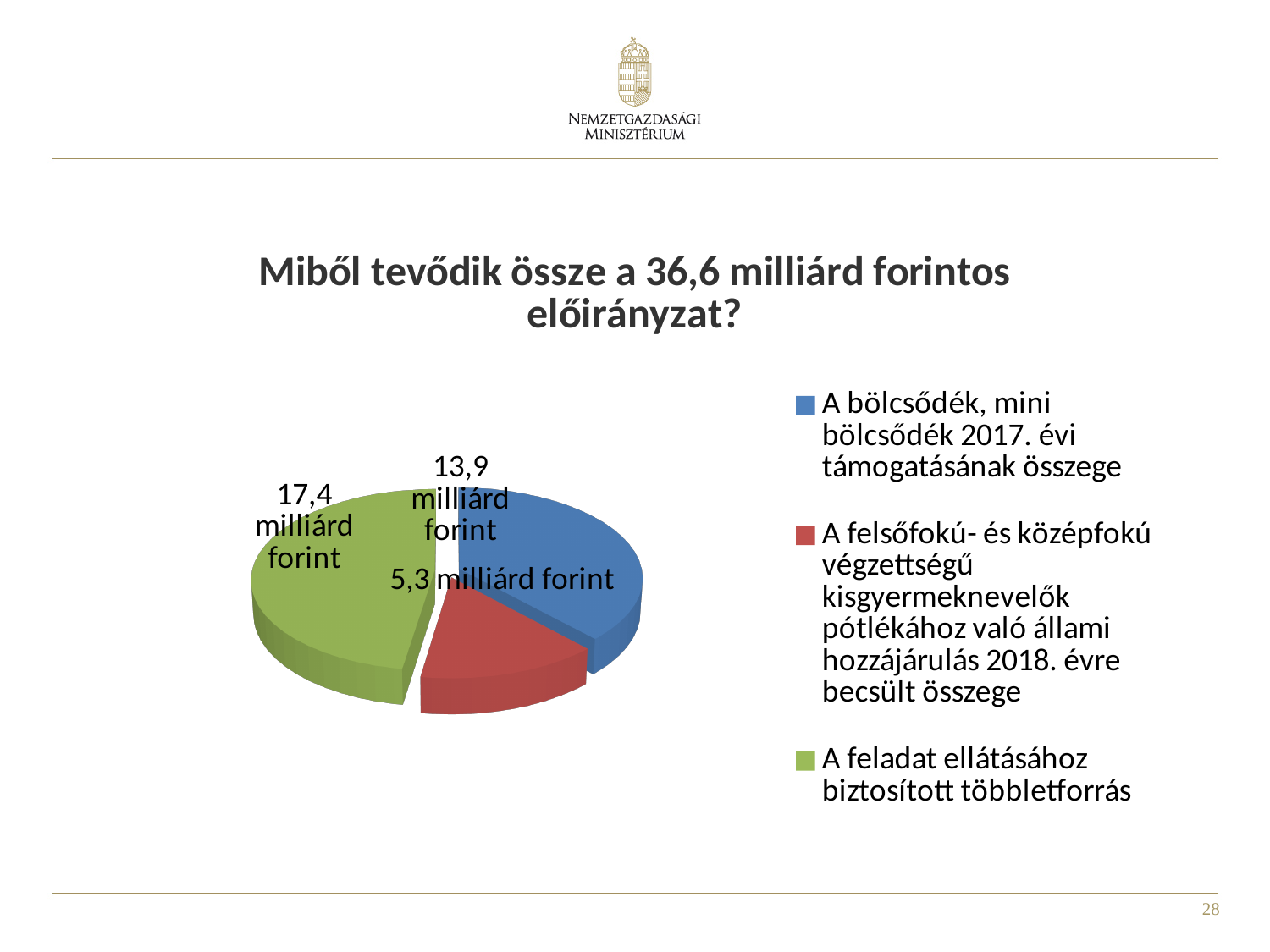
How many entries does the legend list? 3 How many slices does the pie chart have? 3 What kind of chart is shown on the slide? pie chart What is the difference between the largest slice (17,4 milliárd forint) and the smallest slice (5,3 milliárd forint)? 12,1 milliárd forint Which slice of the pie chart is the largest? A feladat ellátásához biztosított többletforrás What colour is the slice for "A feladat ellátásához biztosított többletforrás"? green What is the total of all three slices in the pie chart? 36,6 milliárd forint Which slice of the pie chart is the smallest? A felsőfokú- és középfokú végzettségű kisgyermeknevelők pótlékához való állami hozzájárulás 2018. évre becsült összege Which is larger: the slice for "A bölcsődék, mini bölcsődék 2017. évi támogatásának összege" or the slice for "A feladat ellátásához biztosított többletforrás"? A feladat ellátásához biztosított többletforrás What is the value of the slice for "A feladat ellátásához biztosított többletforrás"? 17,4 milliárd forint What is the value of the slice for "A bölcsődék, mini bölcsődék 2017. évi támogatásának összege"? 13,9 milliárd forint What is the value of the slice for "A felsőfokú- és középfokú végzettségű kisgyermeknevelők pótlékához való állami hozzájárulás 2018. évre becsült összege"? 5,3 milliárd forint